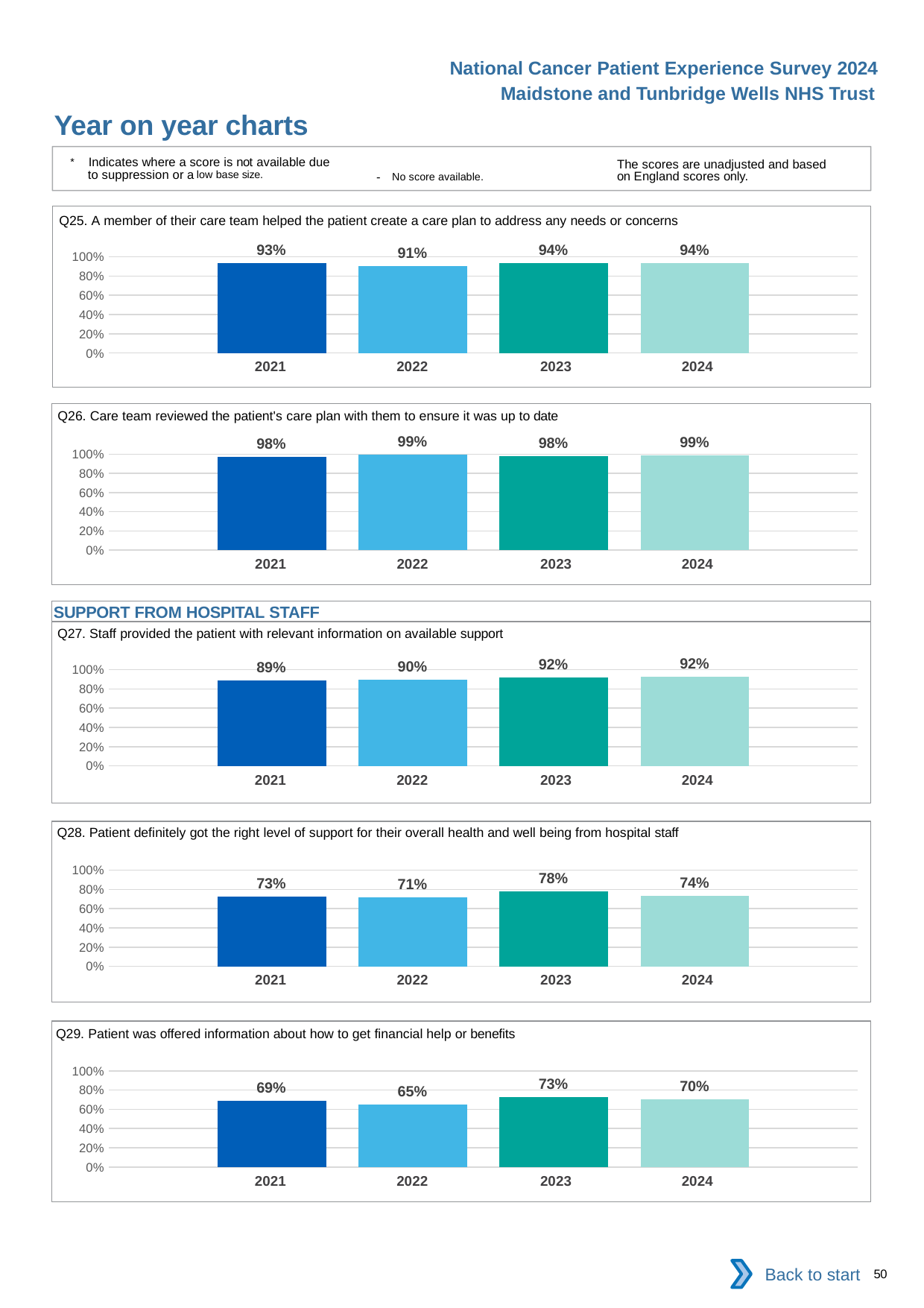
In the Q28 chart, which year has the highest value? 2023 In the Q26 chart, what is the value for 2024? 99% What kind of chart is the Q25 chart? bar chart In the Q28 chart, is the value for 2024 greater or less than 60%? greater In the Q27 chart, what is the value for 2021? 89% In the Q29 chart, which year has the lowest value? 2022 In the Q25 chart, what is the value for 2022? 91% In the Q29 chart, which is larger, the value for 2021 or the value for 2024? 2024 In the Q28 chart, what is the difference between the 2023 and 2022 values? 7% In the Q27 chart, do the values rise or fall from 2021 to 2024? rise How many years are shown on the x axis of the Q27 chart? 4 How many charts are shown on the slide? 5